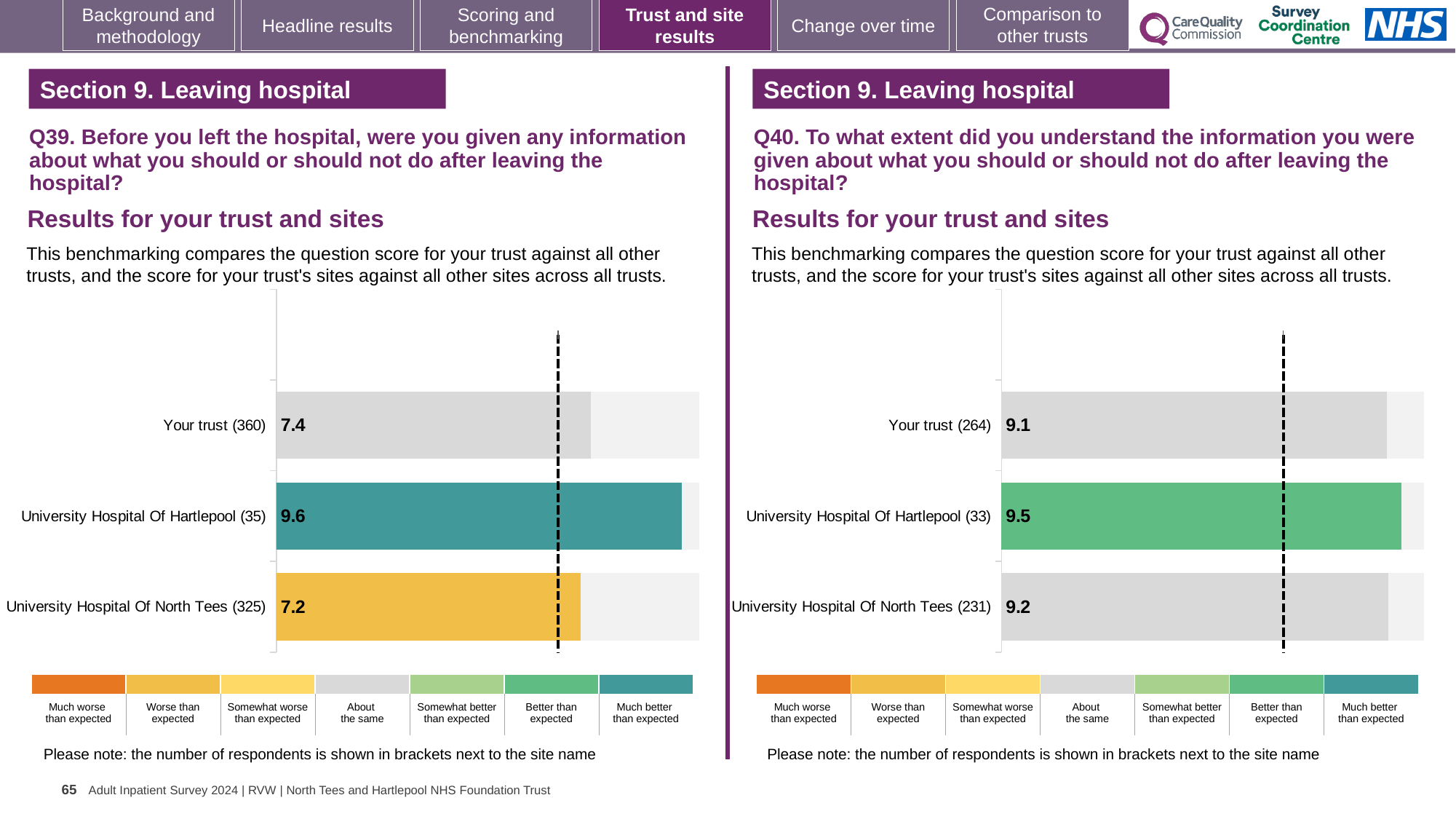
On the Q39 chart (left), what is the score for Your trust? 7.4 On the Q39 chart (left), what is the score for University Hospital Of North Tees? 7.2 On the Q40 chart (right), what is the score for University Hospital Of North Tees? 9.2 On the Q40 chart (right), which site or trust has the lowest score? Your trust How many bars are shown on the Q39 chart (left)? 3 On the Q40 chart (right), which has the larger score: University Hospital Of Hartlepool or University Hospital Of North Tees? University Hospital Of Hartlepool On the Q39 chart (left), which site or trust has the highest score? University Hospital Of Hartlepool On the Q40 chart (right), what is the score for Your trust? 9.1 On the Q39 chart (left), what is the score for University Hospital Of Hartlepool? 9.6 On the Q40 chart (right), what is the difference between the scores for University Hospital Of Hartlepool and Your trust? 0.4 What type of chart is used on the Q40 chart (right)? Bar chart On the Q39 chart (left), what is the difference between the scores for University Hospital Of Hartlepool and University Hospital Of North Tees? 2.4